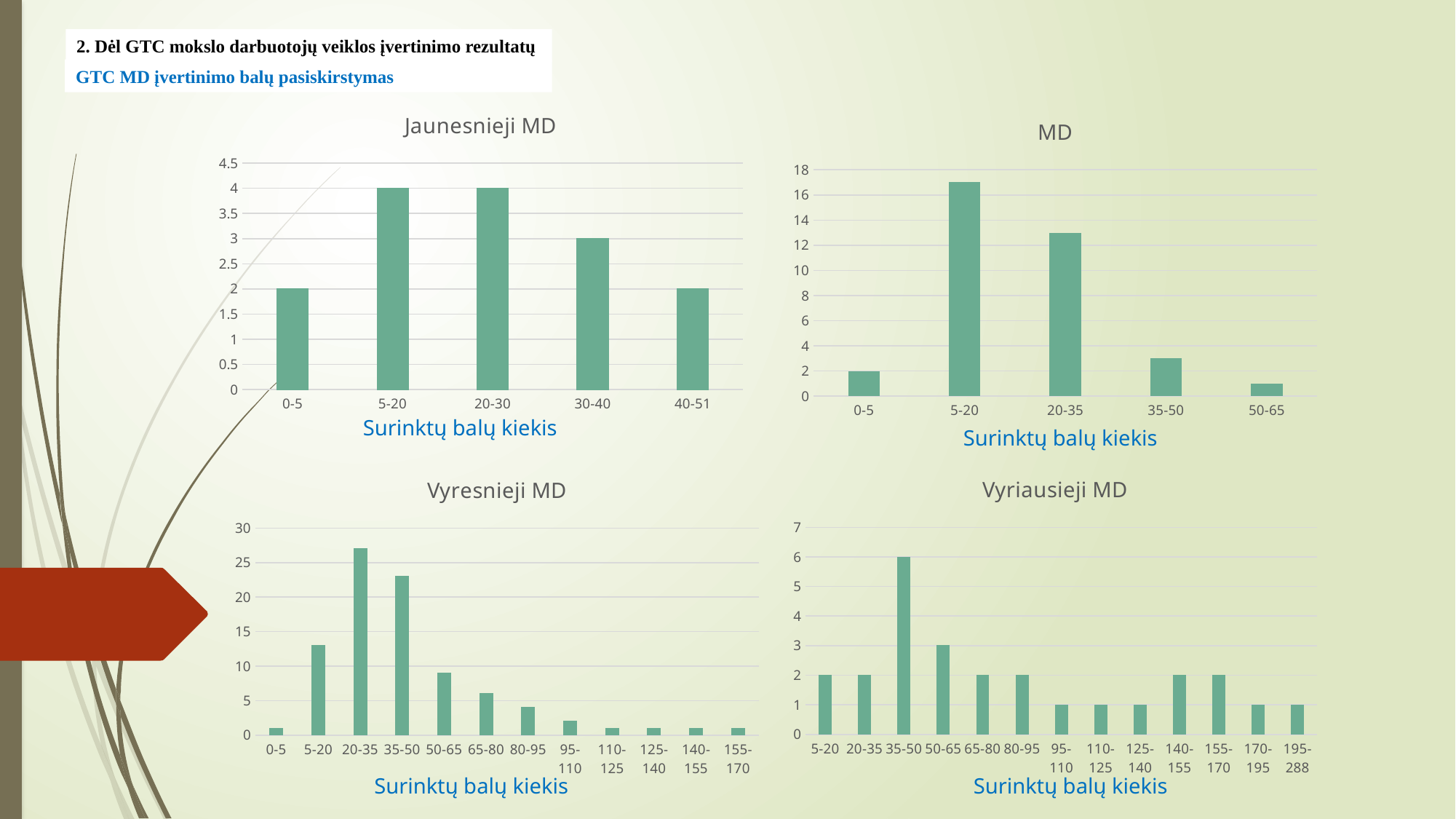
In the 'Vyresnieji MD' chart, which category has the highest value? 20-35 In the 'MD' chart, which category has the highest value? 5-20 In the 'Jaunesnieji MD' chart, what is the difference between the values for 5-20 and 40-51? 2 In the 'Vyriausieji MD' chart, what is the value for the 35-50 category? 6 In the 'Jaunesnieji MD' chart, what is the value for the 0-5 category? 2 In the 'Vyresnieji MD' chart, which is larger, the value for 50-65 or the value for 65-80? 50-65 What type of chart is the 'Vyriausieji MD' chart? bar chart How many categories are shown on the x axis of the 'Vyriausieji MD' chart? 13 In the 'MD' chart, is the value for 20-35 greater or less than 12? greater In the 'Vyresnieji MD' chart, is the value for 5-20 greater or less than 10? greater In the 'MD' chart, what is the value for the 0-5 category? 2 In the 'Jaunesnieji MD' chart, what is the value for the 30-40 category? 3